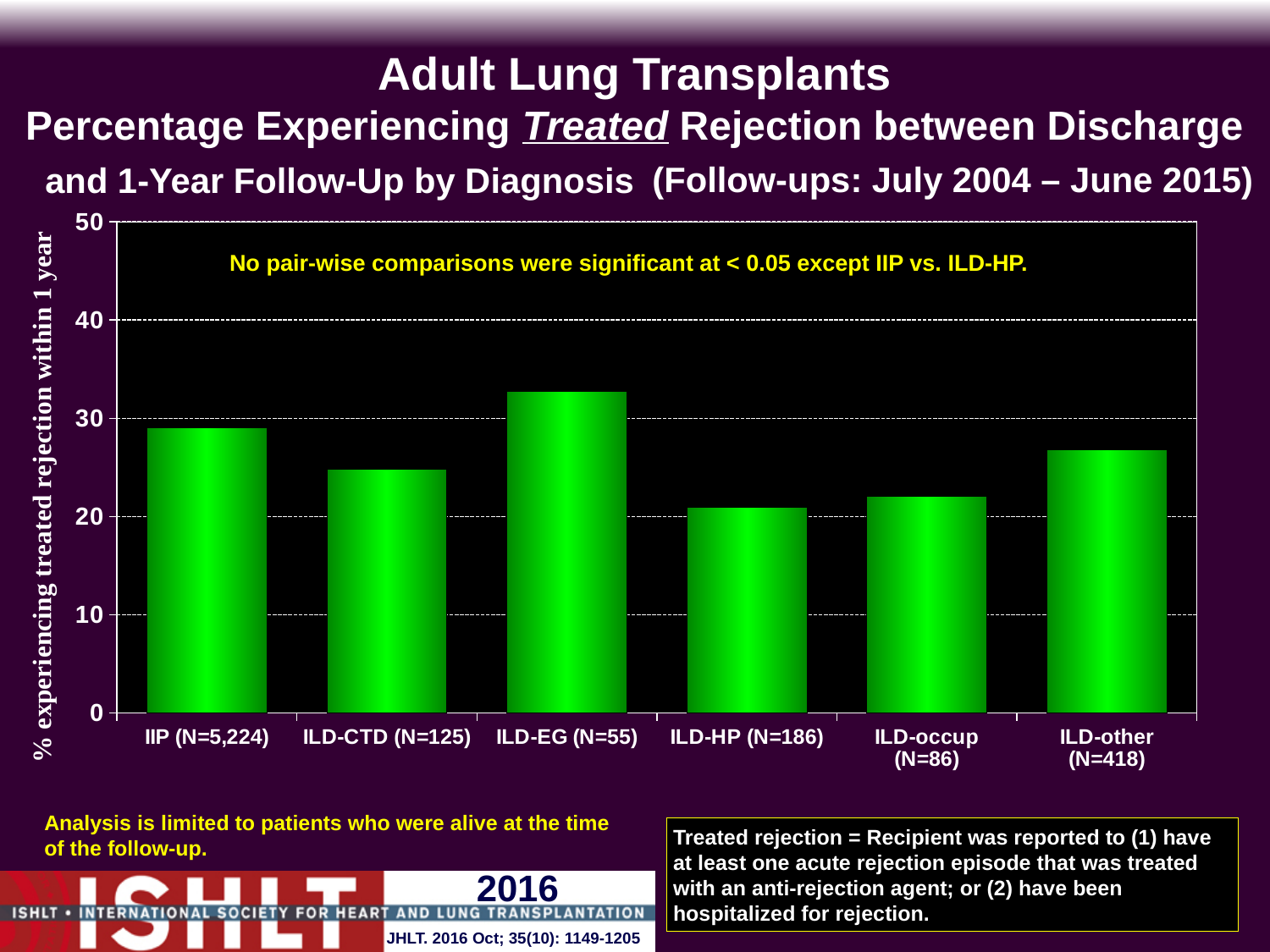
How many diagnosis categories are plotted on the chart? 6 Is the value for IIP (N=5,224) greater or less than 20? greater What kind of chart is shown on the slide? bar chart Is the value for ILD-CTD (N=125) greater or less than 30? less Is the value for ILD-occup (N=86) greater or less than 30? less Which is larger, the value for ILD-EG (N=55) or the value for ILD-other (N=418)? ILD-EG (N=55) Which is larger, the value for IIP (N=5,224) or the value for ILD-CTD (N=125)? IIP (N=5,224) What is the label on the vertical axis of the chart? % experiencing treated rejection within 1 year Which diagnosis category has the highest percentage experiencing treated rejection within 1 year? ILD-EG (N=55) According to the note on the chart, which pair-wise comparison was significant at < 0.05? IIP vs. ILD-HP